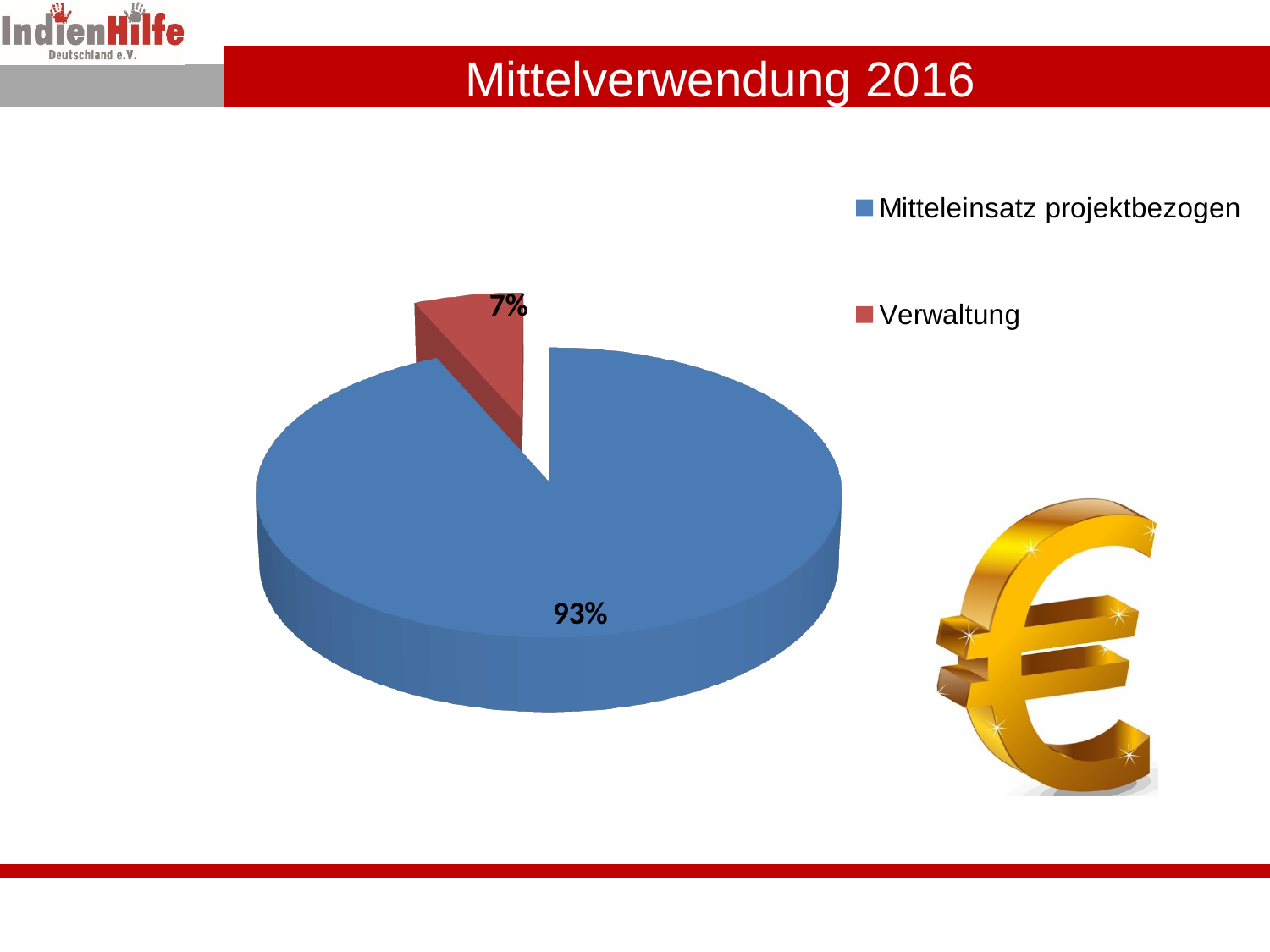
What is the difference in percentage points between Mitteleinsatz projektbezogen and Verwaltung? 86 Which category has the largest slice of the pie? Mitteleinsatz projektbezogen How many slices does the pie chart have? 2 What share of the pie does Verwaltung represent? 7% How many entries does the legend list? 2 Which category has the smallest slice of the pie? Verwaltung What colour is the slice for Verwaltung? red What share of the pie does Mitteleinsatz projektbezogen represent? 93% What is the title of the slide containing the chart? Mittelverwendung 2016 What kind of chart is shown on the slide? pie chart Which is larger, the share for Verwaltung or the share for Mitteleinsatz projektbezogen? Mitteleinsatz projektbezogen